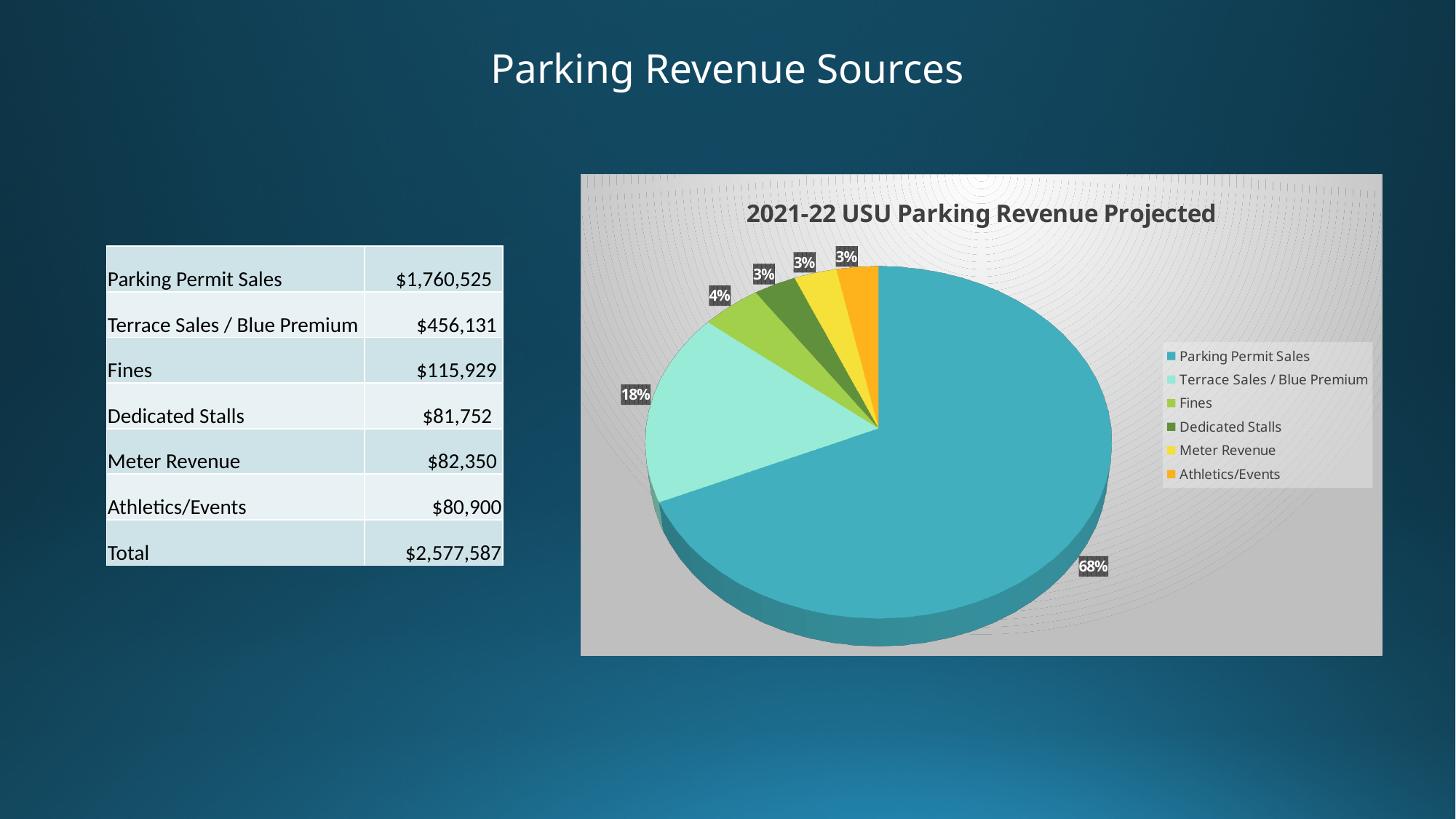
What is the difference in percentage points between the Parking Permit Sales slice and the Terrace Sales / Blue Premium slice? 50 Which slice is larger in the pie chart: Terrace Sales / Blue Premium or Fines? Terrace Sales / Blue Premium What type of chart is shown on the slide? pie chart How many slices does the pie chart have? 6 Which category has the largest slice of the pie chart? Parking Permit Sales What percentage is shown for Dedicated Stalls in the pie chart? 3% What percentage is shown for Fines in the pie chart? 4% How many entries does the chart's legend list? 6 What share of the pie does Parking Permit Sales represent? 68% What is the title of the chart? 2021-22 USU Parking Revenue Projected Which colour represents Athletics/Events in the pie chart's legend? orange What share of the pie does Terrace Sales / Blue Premium represent? 18%